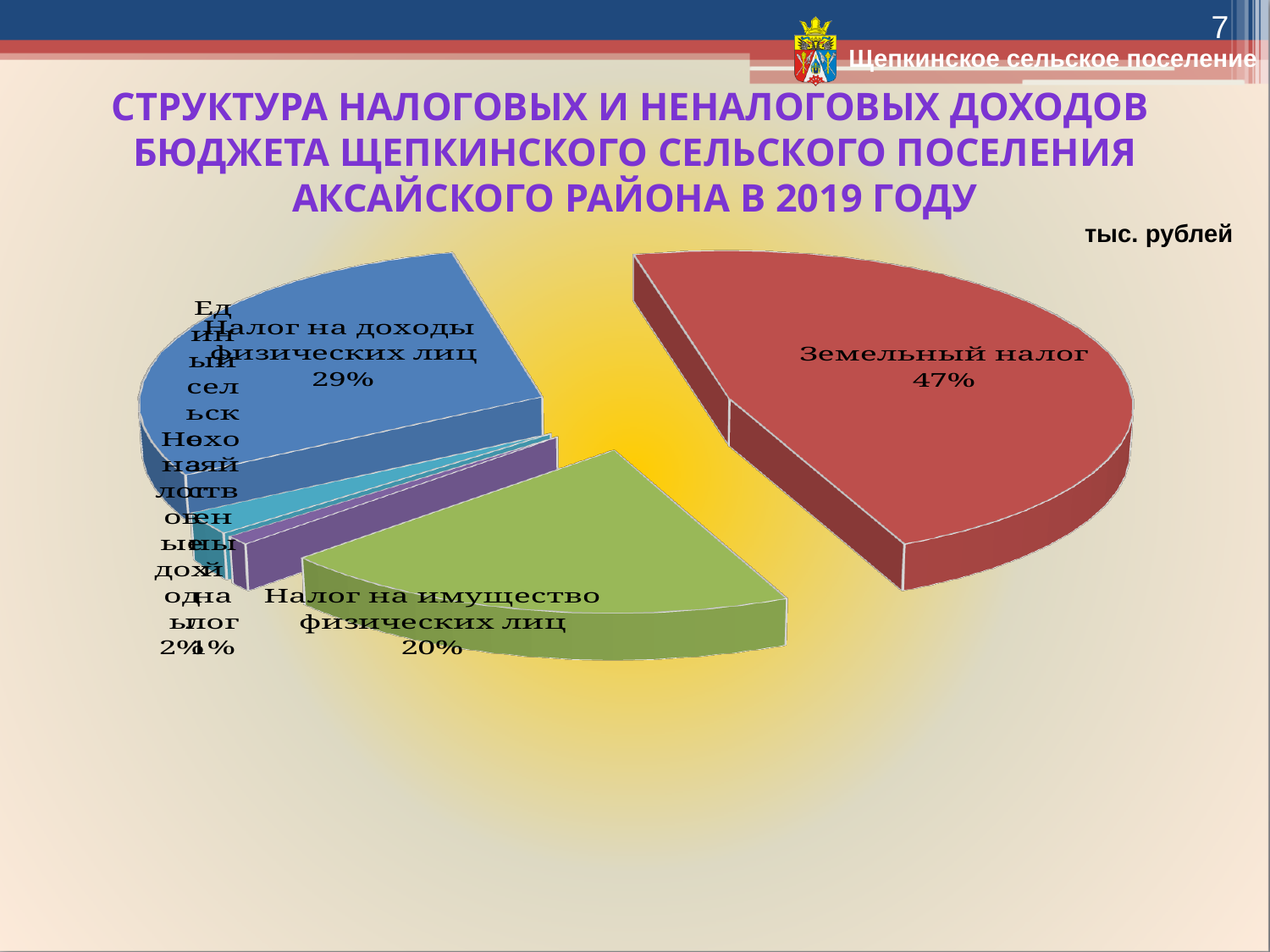
What share of the pie does Налог на имущество физических лиц represent? 20% Which category has the largest slice of the pie? Земельный налог What unit is indicated above the chart? тыс. рублей Is the share for Земельный налог greater or less than 50%? less What is the difference in percentage points between Земельный налог and Налог на доходы физических лиц? 18 What colour is the slice for Земельный налог? Red What share of the pie does Налог на доходы физических лиц represent? 29% How many slices does the pie chart have? 5 What share of the pie does Земельный налог represent? 47% What kind of chart is shown on the slide? Pie chart Which is larger: Налог на доходы физических лиц or Налог на имущество физических лиц? Налог на доходы физических лиц What is the difference in percentage points between Земельный налог and Налог на имущество физических лиц? 27